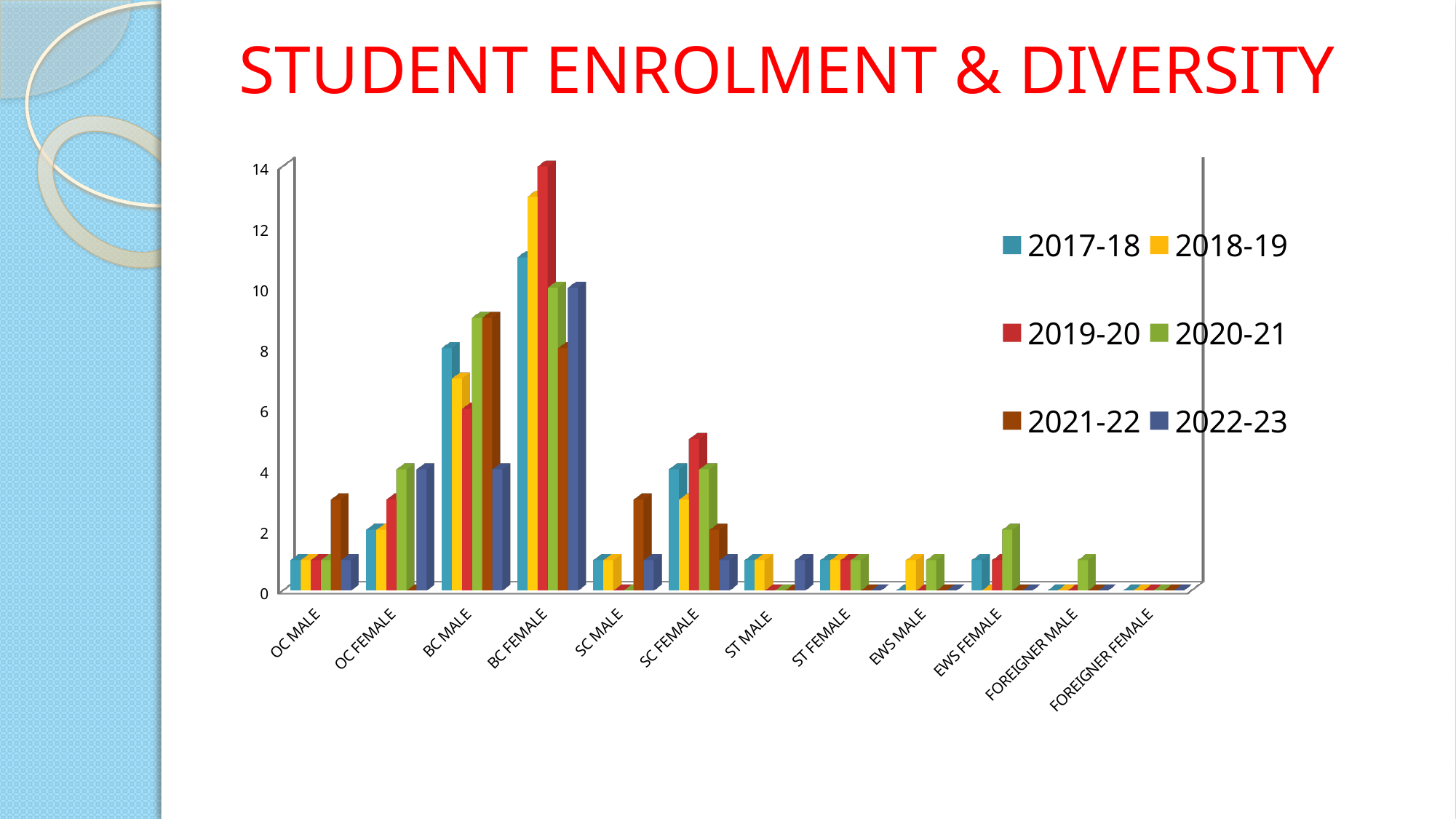
What is the title of the slide containing the chart? STUDENT ENROLMENT & DIVERSITY How many series does the legend list? 6 Is the value for OC MALE in 2017-18 greater or less than 2? less Is the value for BC MALE in 2021-22 greater or less than 8? greater What kind of chart is shown on the slide? bar chart Which is larger for 2019-20: BC MALE or BC FEMALE? BC FEMALE Is the value for SC MALE in 2021-22 greater or less than 2? greater Which is larger for 2017-18: BC MALE or SC FEMALE? BC MALE Which series has the highest value for BC FEMALE? 2019-20 How many categories are shown on the x axis? 12 Which category has the tallest bar in the chart? BC FEMALE